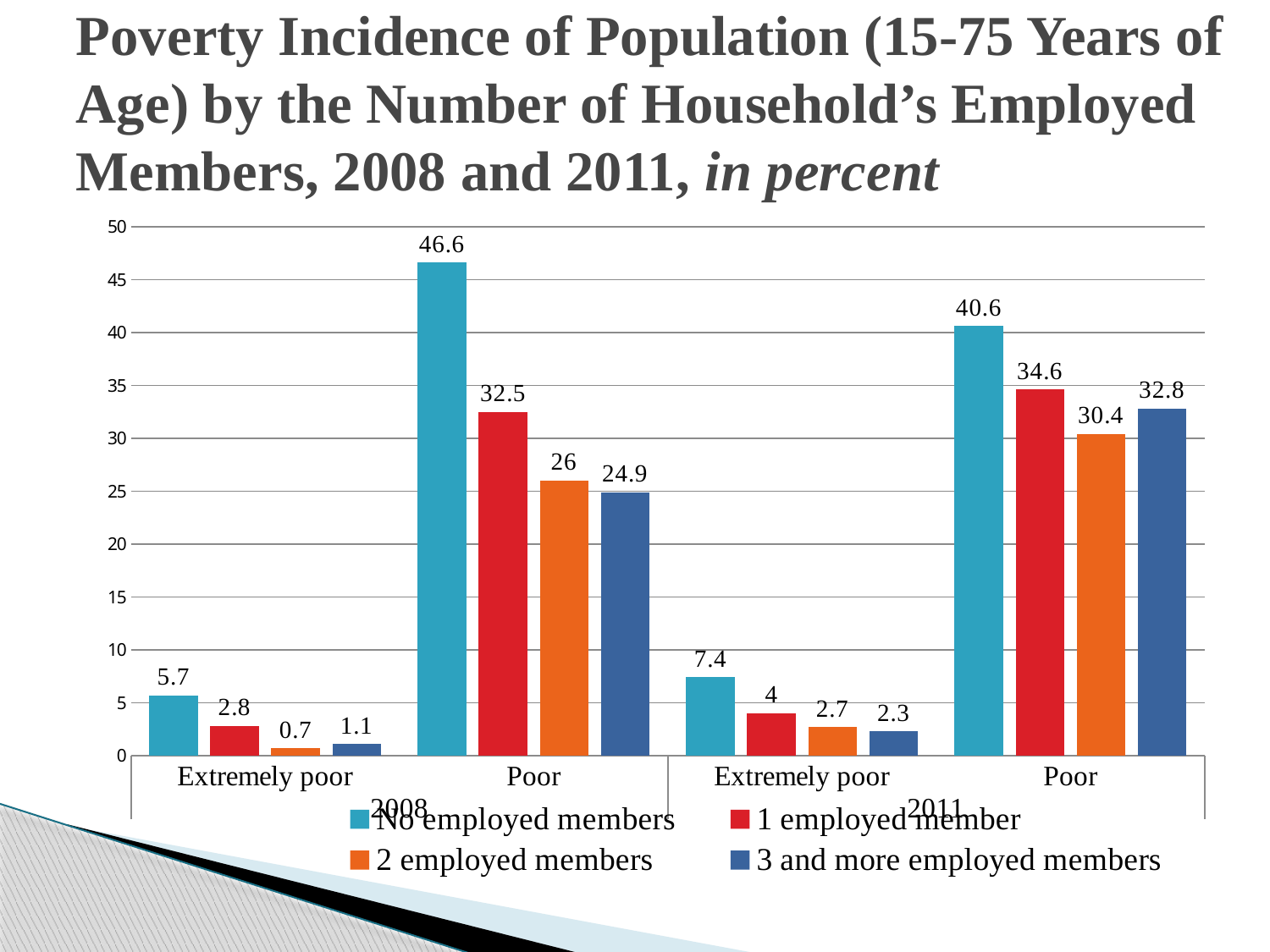
What kind of chart is shown on the slide? Bar chart What is the value for 2 employed members in the Extremely poor category in 2011? 2.7 Which series has the lowest value in the Extremely poor category in 2008? 2 employed members What is the difference between the 2 employed members and 3 and more employed members values in the Poor category in 2008? 1.1 Which series has the highest value in the Poor category in 2011? No employed members What is the difference between the No employed members values for the Poor category in 2008 and 2011? 6 How many category groups are shown along the x axis? 4 How many series does the legend list? 4 What is the poverty incidence for households with no employed members in the Poor category in 2008? 46.6 What is the value for 3 and more employed members in the Poor category in 2011? 32.8 What colour represents the 1 employed member series? Red Which is larger: the 1 employed member value for Poor in 2008 or for Poor in 2011? Poor in 2011